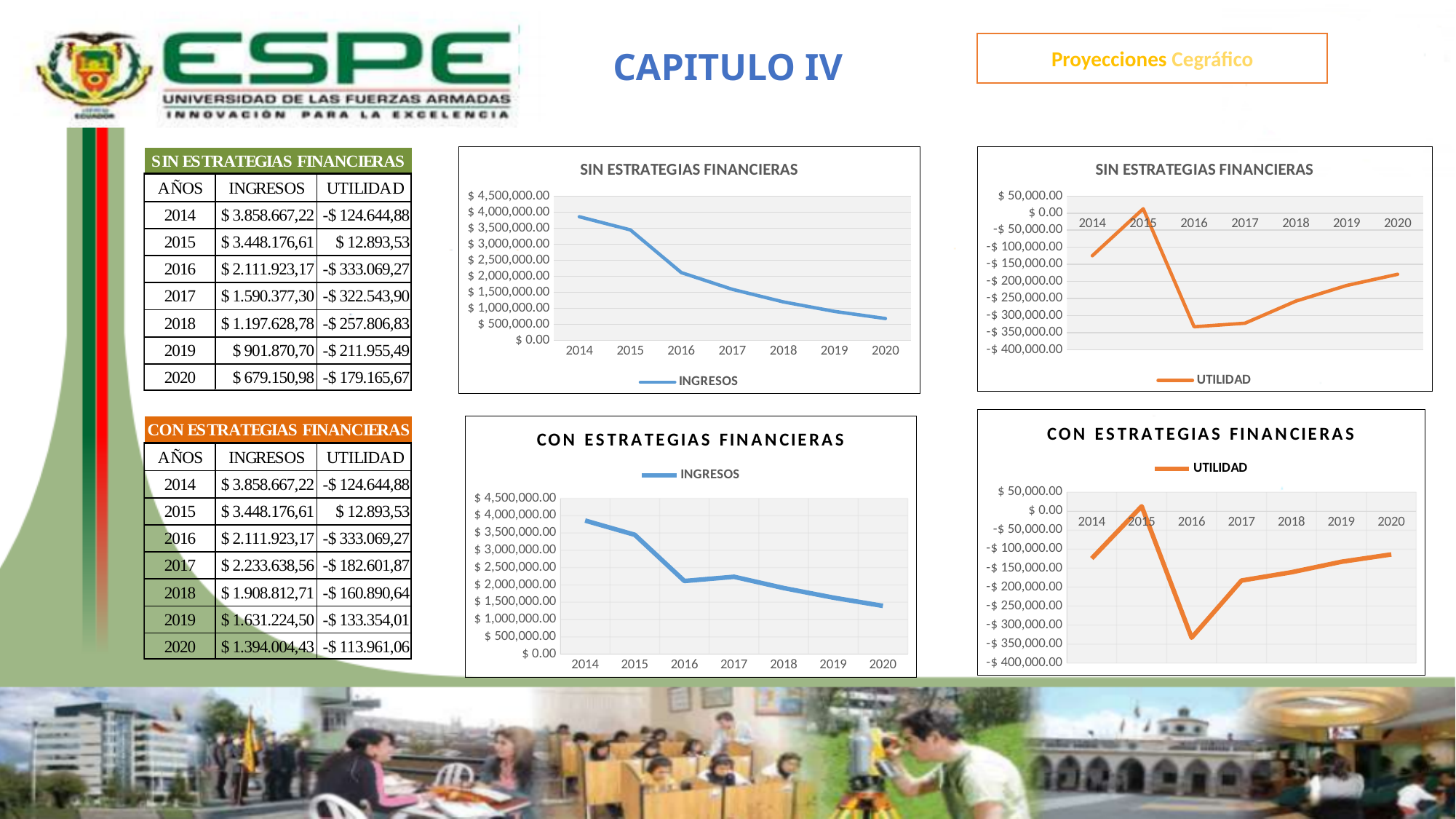
In the top-left SIN ESTRATEGIAS FINANCIERAS INGRESOS chart, is the value for 2020 greater or less than $ 1,000,000.00? less In the top-left SIN ESTRATEGIAS FINANCIERAS INGRESOS chart, is the value for 2014 greater or less than $ 3,500,000.00? greater What series name appears in the legend of the bottom-left CON ESTRATEGIAS FINANCIERAS chart? INGRESOS In the bottom-left CON ESTRATEGIAS FINANCIERAS INGRESOS chart, which year has the larger value, 2016 or 2017? 2017 In the top-left SIN ESTRATEGIAS FINANCIERAS INGRESOS chart, how many years are shown on the x axis? 7 How many series does the legend of the top-right SIN ESTRATEGIAS FINANCIERAS chart list? 1 What kind of chart is the top-left chart titled SIN ESTRATEGIAS FINANCIERAS (INGRESOS)? Line chart In the top-right SIN ESTRATEGIAS FINANCIERAS UTILIDAD chart, which year has the lowest value? 2016 In the top-left SIN ESTRATEGIAS FINANCIERAS INGRESOS chart, do the values rise or fall from 2014 to 2020? Fall In the bottom-left CON ESTRATEGIAS FINANCIERAS INGRESOS chart, is the value for 2020 greater or less than $ 1,000,000.00? greater In the top-right SIN ESTRATEGIAS FINANCIERAS UTILIDAD chart, which year has the highest value? 2015